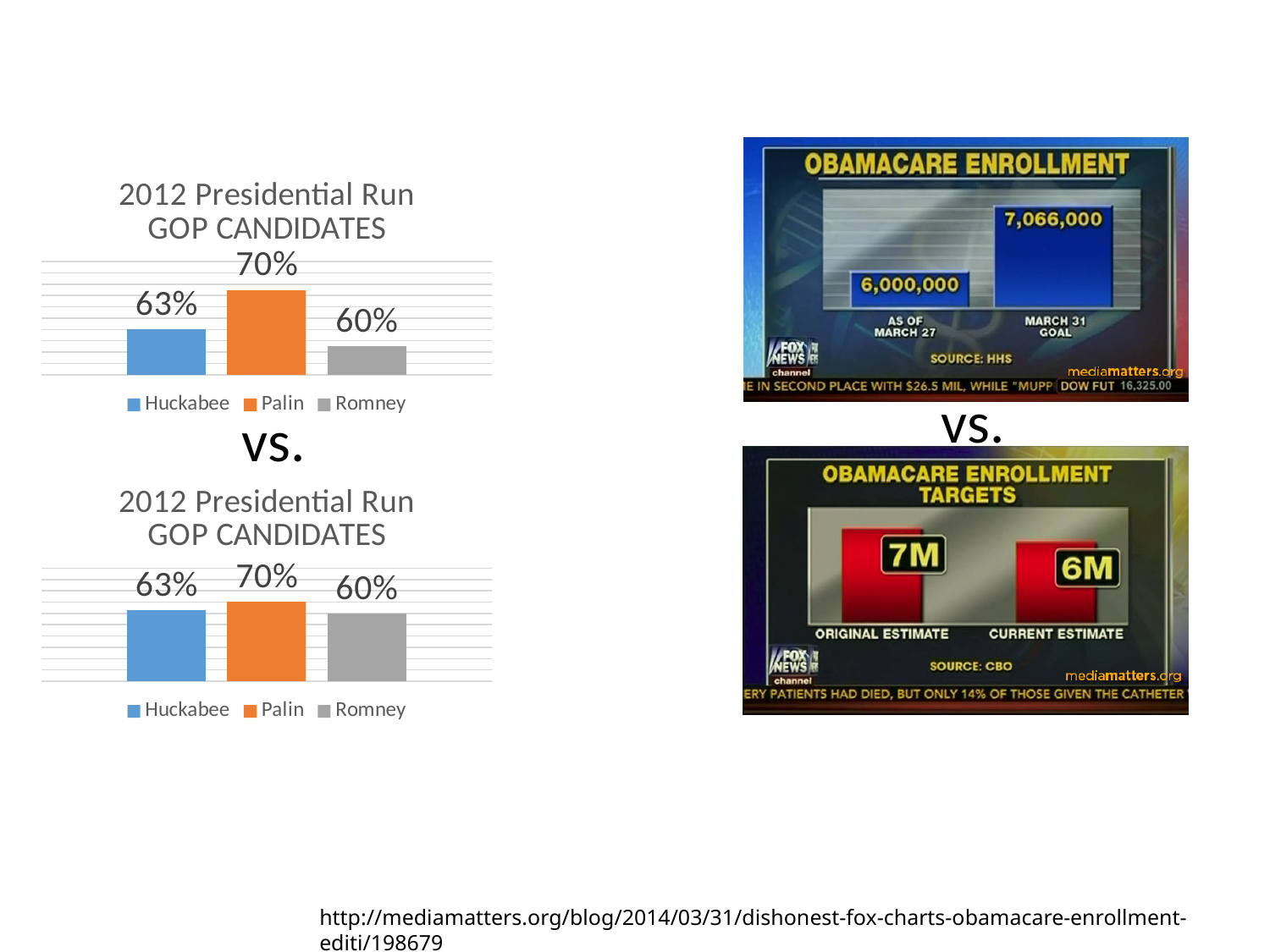
In the bottom-left chart titled '2012 Presidential Run GOP CANDIDATES', which candidate has the highest value? Palin In the top-right chart titled 'OBAMACARE ENROLLMENT', what is the value for 'As of March 27'? 6,000,000 What kind of chart is the top-left chart titled '2012 Presidential Run GOP CANDIDATES'? Bar chart How many bars are shown in the top-right chart titled 'OBAMACARE ENROLLMENT'? 2 How many entries does the legend of the bottom-left chart titled '2012 Presidential Run GOP CANDIDATES' list? 3 In the top-left chart titled '2012 Presidential Run GOP CANDIDATES', what is the difference between Palin's and Huckabee's values? 7% In the top-right chart titled 'OBAMACARE ENROLLMENT', what is the value for 'March 31 Goal'? 7,066,000 In the bottom-right chart titled 'OBAMACARE ENROLLMENT TARGETS', what is the value for 'Current Estimate'? 6M In the bottom-right chart titled 'OBAMACARE ENROLLMENT TARGETS', which is larger, the Original Estimate or the Current Estimate? Original Estimate In the top-left chart titled '2012 Presidential Run GOP CANDIDATES', what is the value for Romney? 60% In the bottom-left chart titled '2012 Presidential Run GOP CANDIDATES', which candidate has the lowest value? Romney In the top-left chart titled '2012 Presidential Run GOP CANDIDATES', what is the value for Palin? 70%